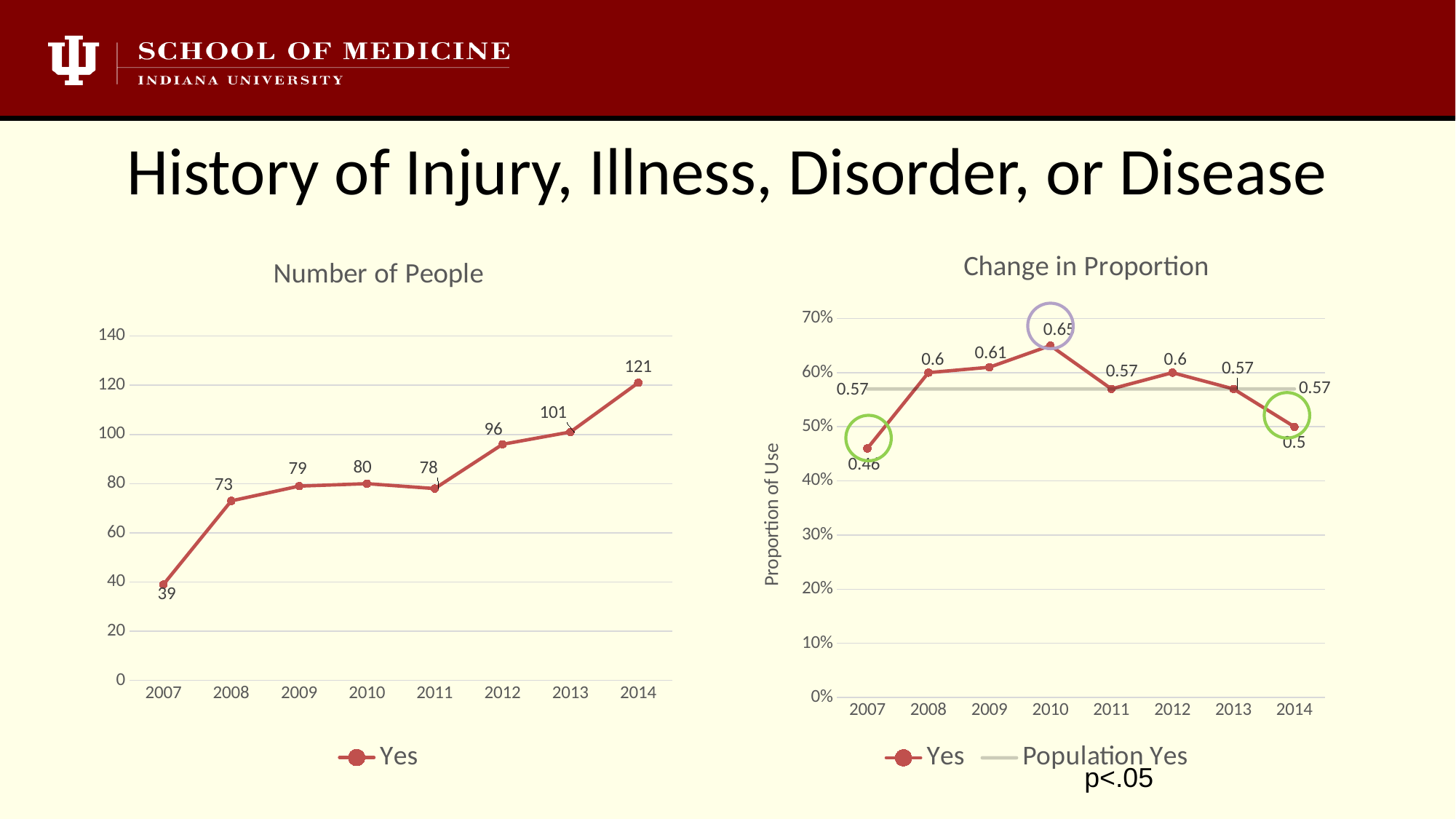
What kind of chart is the "Number of People" chart? Line chart In the "Number of People" chart, how many years are plotted on the x axis? 8 In the "Change in Proportion" chart, what is the value of the Population Yes line? 0.57 In the "Number of People" chart, which year has the lowest value? 2007 In the "Number of People" chart, what is the value for 2014? 121 In the "Change in Proportion" chart, what is the difference between the Yes values for 2010 and 2014? 0.15 In the "Number of People" chart, what is the difference between the values for 2014 and 2013? 20 How many series does the legend of the "Change in Proportion" chart list? 2 In the "Number of People" chart, what is the value for 2007? 39 In the "Number of People" chart, which is larger, the value for 2010 or the value for 2011? 2010 In the "Change in Proportion" chart, what is the Yes value for 2010? 0.65 In the "Change in Proportion" chart, which year has the lowest Yes value? 2007